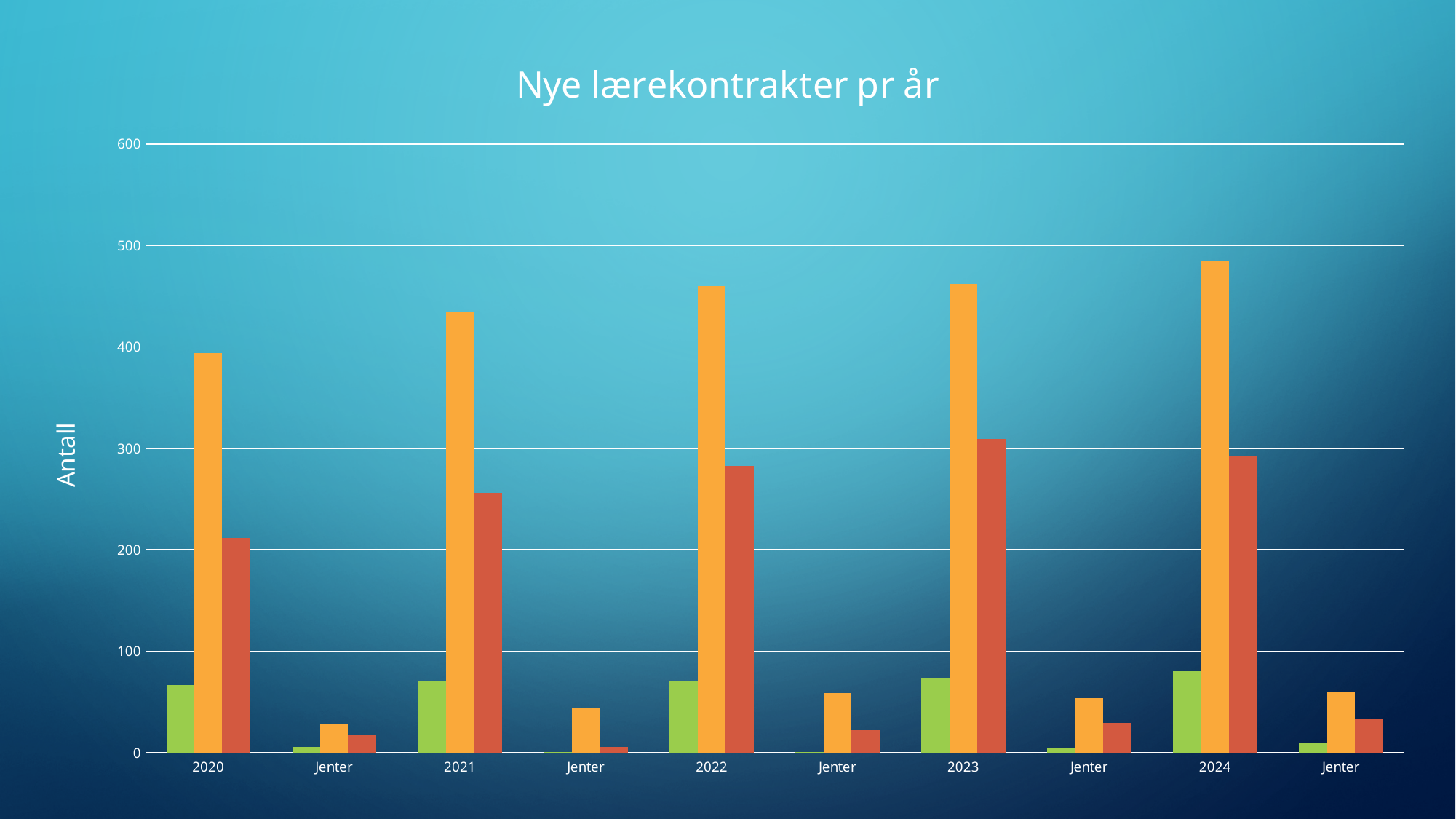
Which is larger, the orange bar for 2024 or the orange bar for 2020? 2024 What is the title of the chart? Nye lærekontrakter pr år What is the label on the vertical axis? Antall How many categories are shown along the x axis? 10 Do the orange bars for the year categories rise or fall from 2020 to 2024? rise What kind of chart is shown on the slide? bar chart Is the value of the orange bar for 2021 greater or less than 400? greater Is the value of the green bar for 2023 greater or less than 100? less Which category has the tallest bar in the chart? 2024 Is the value of the red bar for 2021 greater or less than 300? less